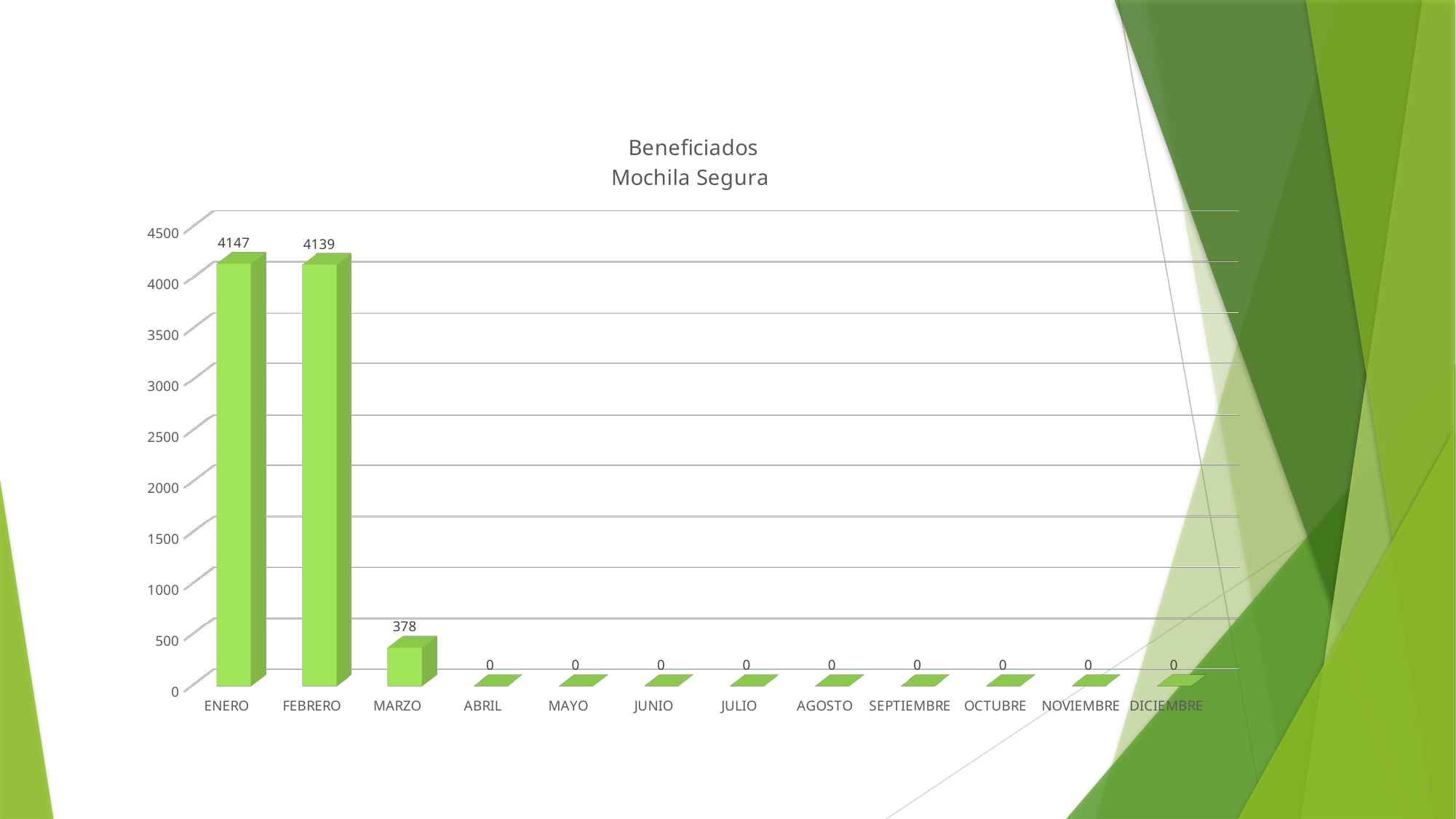
What is the value for FEBRERO? 4139 What kind of chart is shown? bar chart What is the value for ABRIL? 0 Which is larger, the value for MARZO or the value for ABRIL? MARZO What is the title of the chart? Beneficiados Mochila Segura What is the value for ENERO? 4147 Which month has the highest value? ENERO What is the difference between the values for ENERO and FEBRERO? 8 How many months are shown on the x axis? 12 Is the value for MARZO greater or less than 500? less What is the value for MARZO? 378 What is the difference between the values for FEBRERO and MARZO? 3761